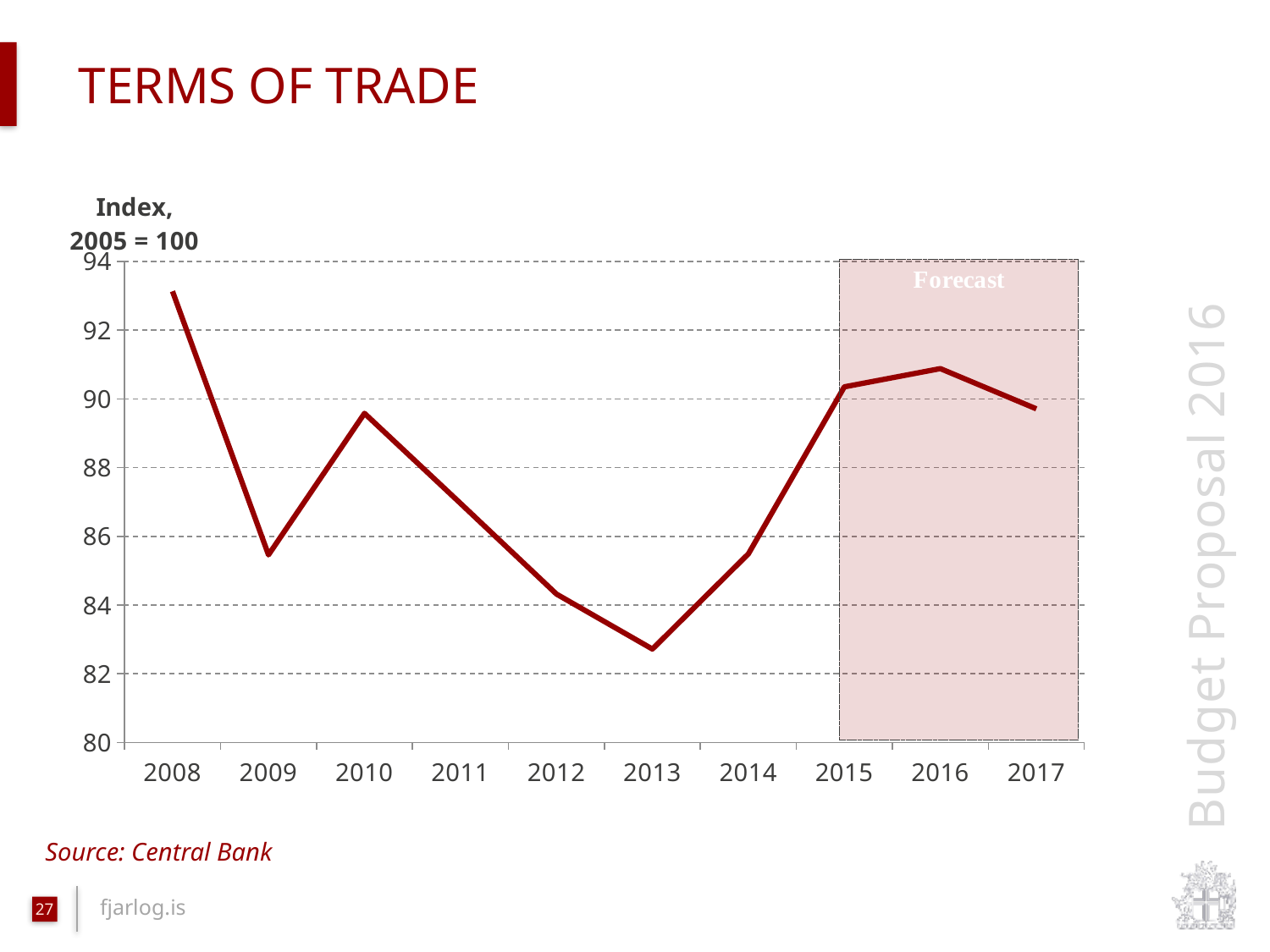
Which year has the lowest terms of trade index value? 2013 What is the base year of the index according to the axis label? 2005 = 100 Is the value for 2013 greater or less than 84? less What kind of chart is shown on the slide? line chart Which years are covered by the shaded Forecast area? 2015, 2016 and 2017 Which year has the highest terms of trade index value? 2008 Is the value for 2008 greater or less than 92? greater Is the value for 2016 greater or less than 90? greater How many years are plotted on the x axis? 10 Which year has the larger value, 2010 or 2011? 2010 Does the index rise or fall from 2010 to 2013? fall